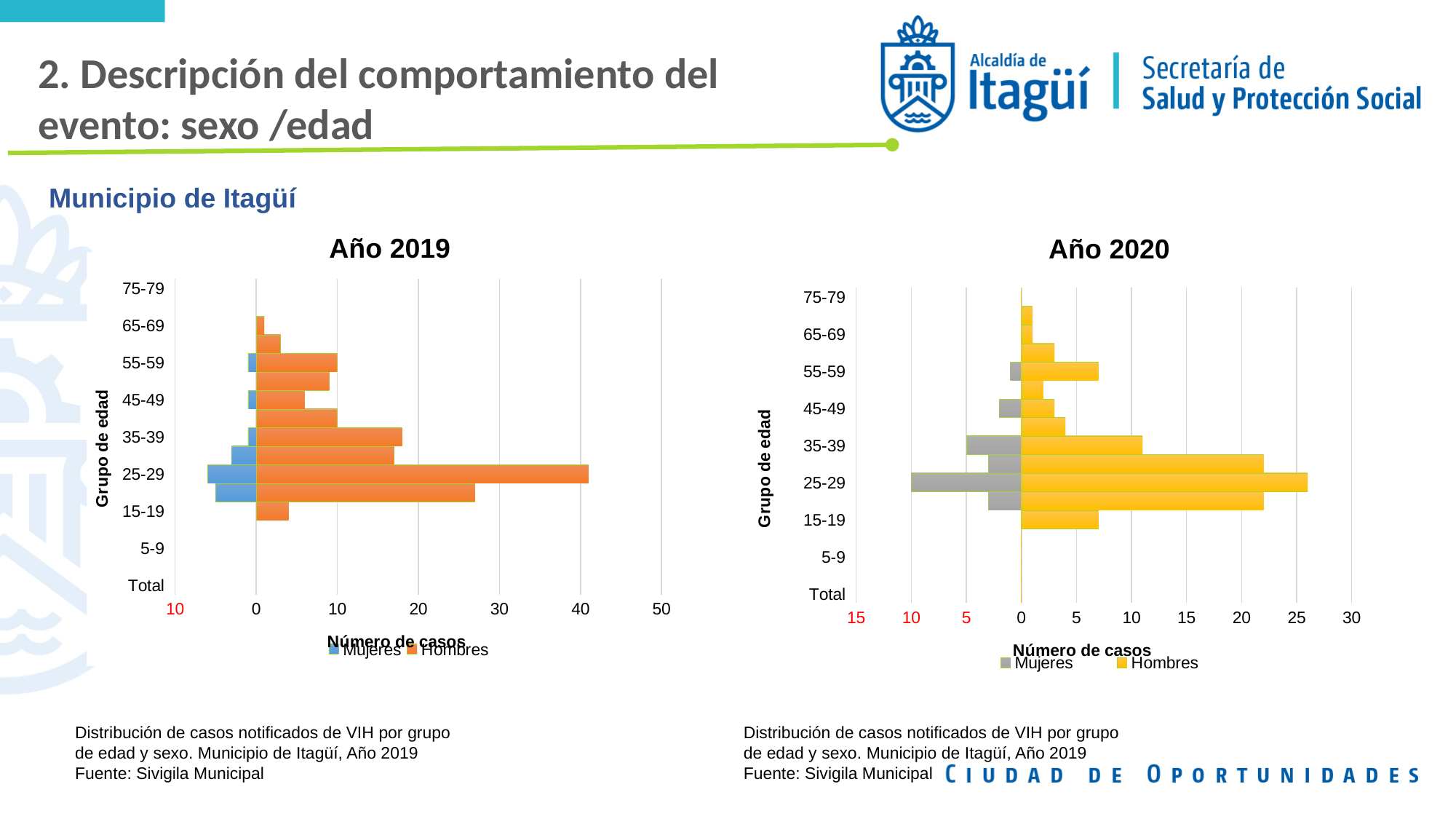
In the 'Año 2019' chart, is the Hombres value for 35-39 greater or less than 20? less What kind of chart is the 'Año 2019' chart? bar chart How many series does the legend of the 'Año 2020' chart list? 2 In the 'Año 2020' chart, which age group has the highest number of Hombres cases? 25-29 In the 'Año 2019' chart, is the Hombres value for 15-19 greater or less than 10? less In the 'Año 2020' chart, for the 25-29 age group, which series has the larger value, Mujeres or Hombres? Hombres In the 'Año 2019' chart, which age group has the highest number of Hombres cases? 25-29 In the 'Año 2020' chart, is the Hombres value for 15-19 greater or less than 10? less What is the x-axis title of the 'Año 2020' chart? Número de casos What are the two series named in the legend of the 'Año 2019' chart? Mujeres and Hombres